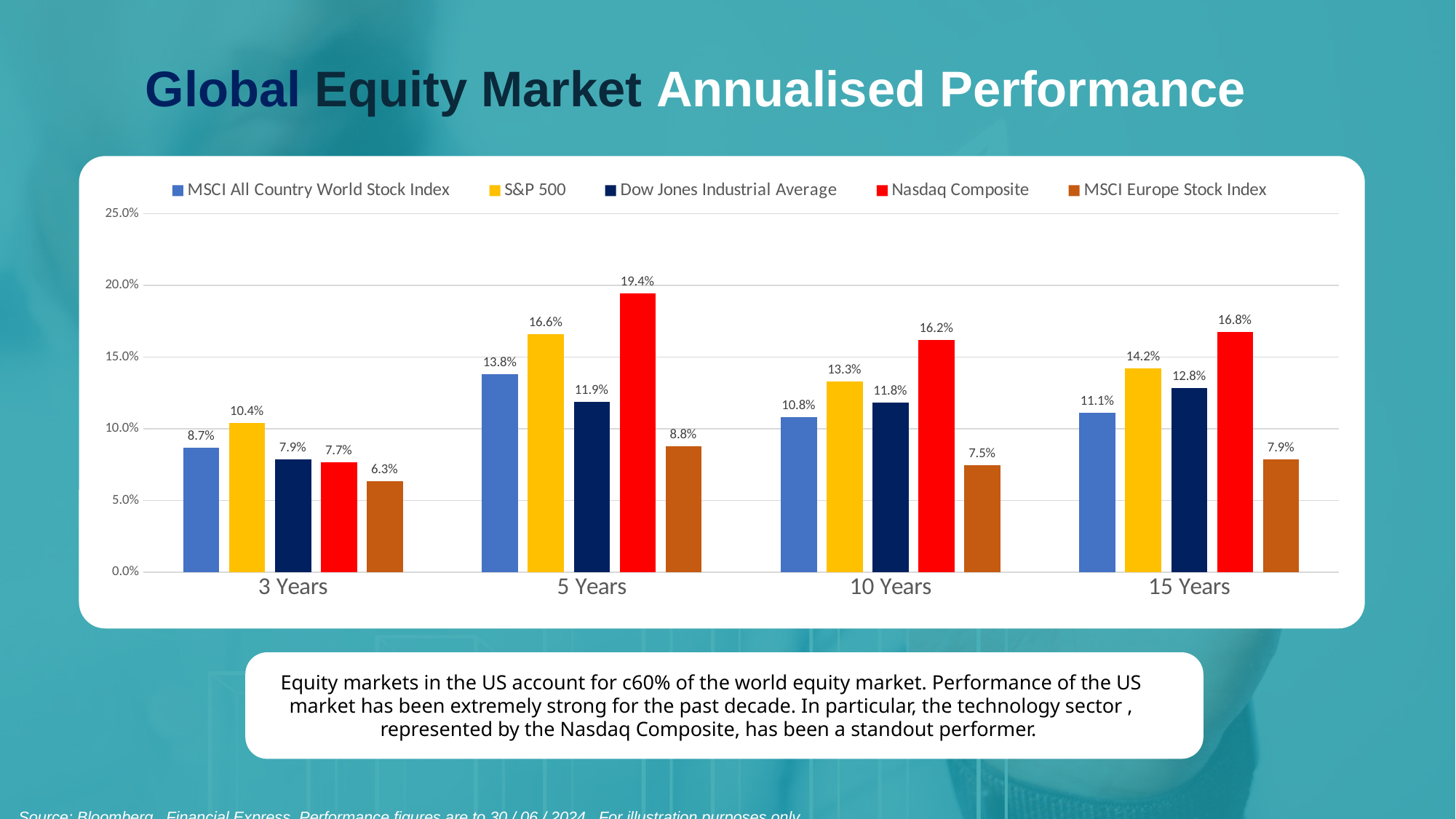
Which index has the highest annualised performance over 10 years? Nasdaq Composite What is the value for the MSCI Europe Stock Index over 3 years? 6.3% Which index has the lowest annualised performance over 15 years? MSCI Europe Stock Index What kind of chart is shown on the slide? Bar chart Over 3 years, which is larger: the S&P 500 or the MSCI All Country World Stock Index? S&P 500 How many series does the legend list? 5 What is the difference between the S&P 500 and the MSCI Europe Stock Index over 5 years? 7.8% Is the value for the Nasdaq Composite over 15 years greater or less than 15.0%? greater What is the value for the Dow Jones Industrial Average over 15 years? 12.8% What is the annualised performance of the Nasdaq Composite over 5 years? 19.4% How many time periods are shown on the x axis? 4 Which colour represents the Nasdaq Composite in the chart? Red